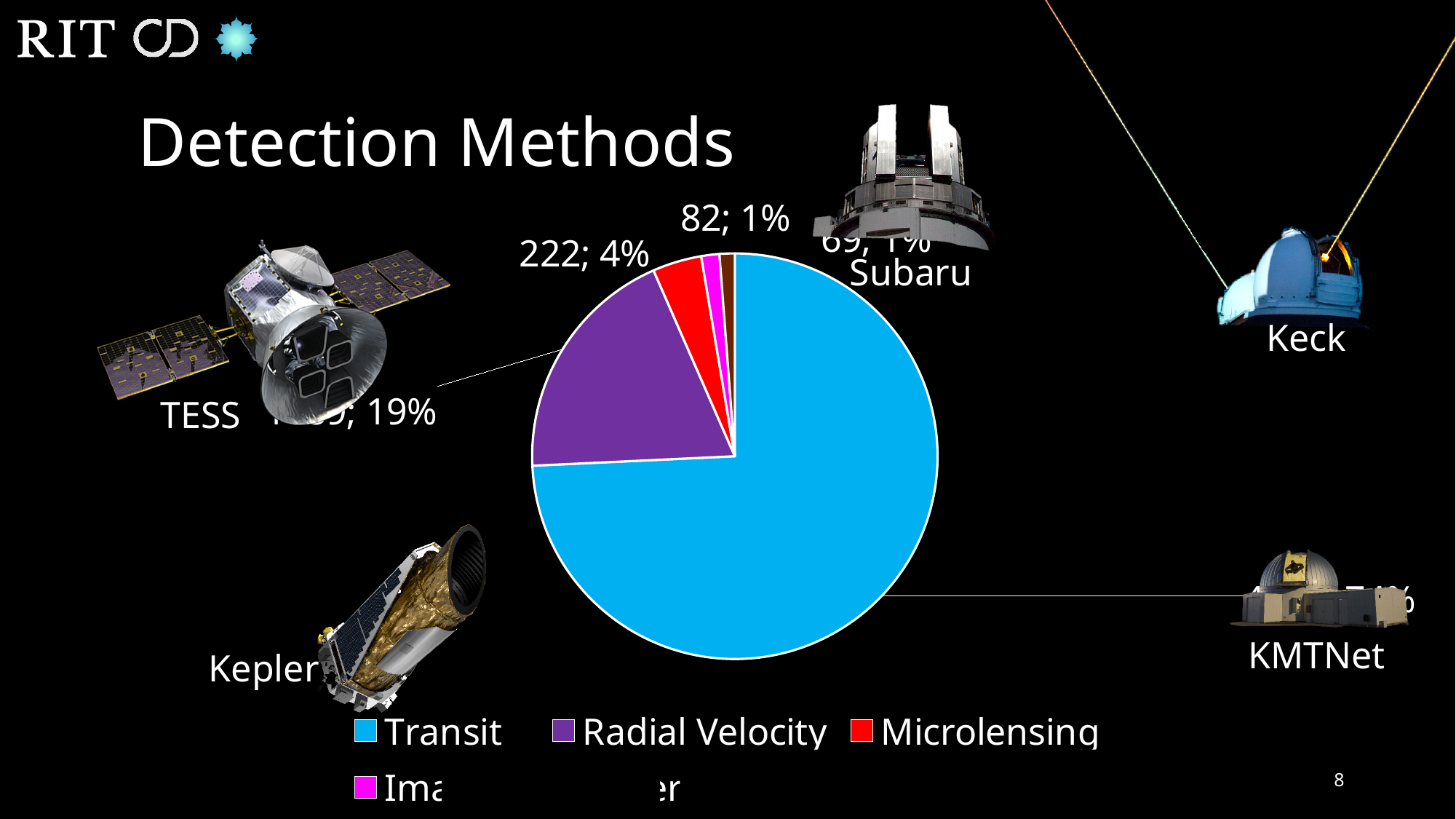
Which detection method has the largest slice of the pie? Transit How many slices does the pie chart have? 5 What share of the pie does Radial Velocity account for? 19% What is the title of the chart? Detection Methods How many planets were detected by Microlensing according to the data label? 222 What share of the pie does Microlensing account for? 4% Which slice is larger, Transit or Radial Velocity? Transit Which slice is larger, Radial Velocity or Microlensing? Radial Velocity What colour is the Transit slice? blue What kind of chart is shown on the slide? pie chart